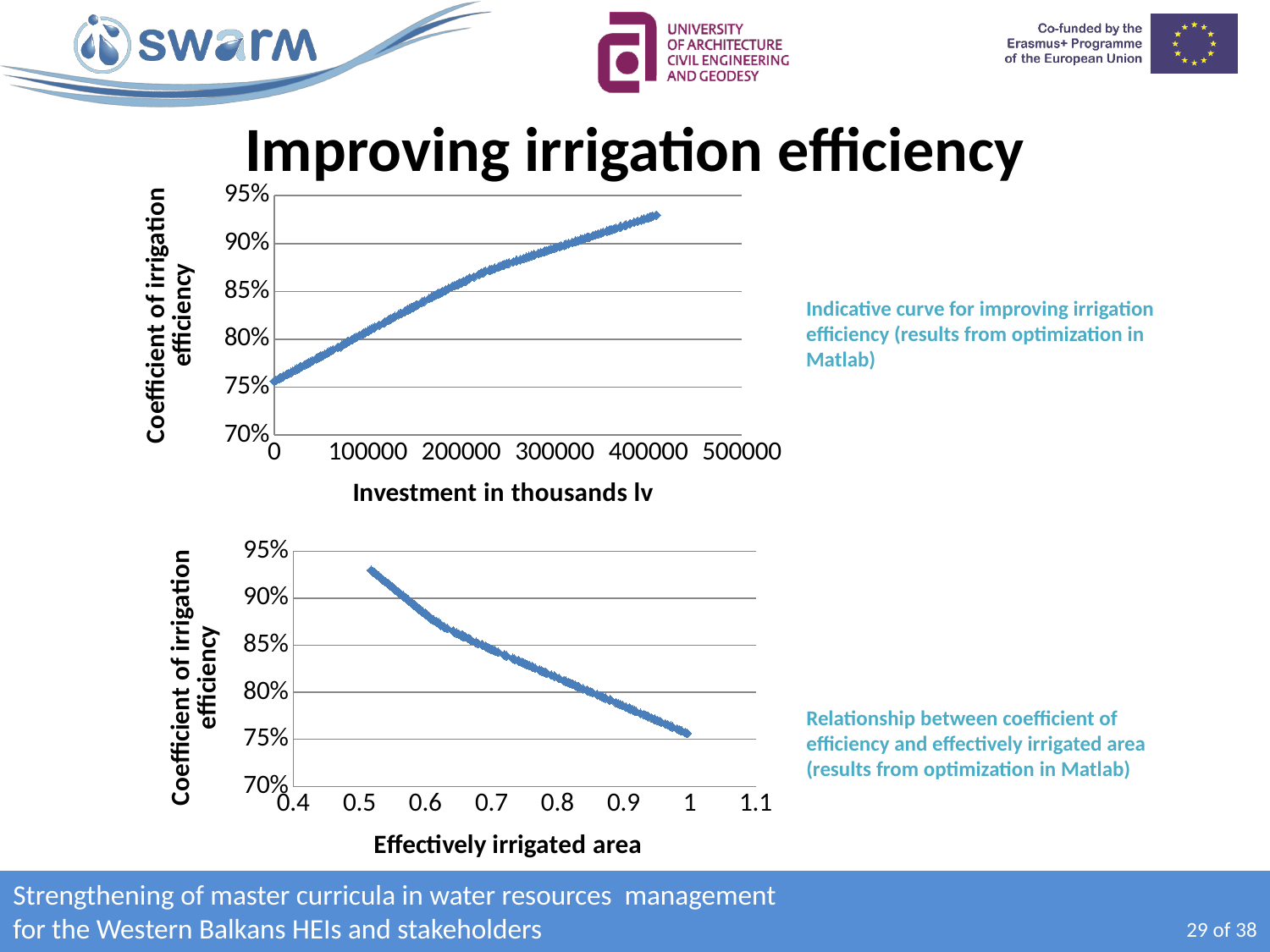
On the top chart, is the coefficient of irrigation efficiency at an investment of 400000 greater or less than 90%? greater What is the x-axis title of the top chart? Investment in thousands lv On the bottom chart, is the coefficient of irrigation efficiency at an effectively irrigated area of 0.8 greater or less than 85%? less On the bottom chart (Effectively irrigated area), do the values rise or fall as the effectively irrigated area increases along the x axis? fall What kind of chart is the top chart on the slide? scatter chart On the top chart, is the coefficient of irrigation efficiency at an investment of 200000 greater or less than 80%? greater On the top chart (Investment in thousands lv), do the values rise or fall as investment increases along the x axis? rise What is the x-axis title of the bottom chart? Effectively irrigated area